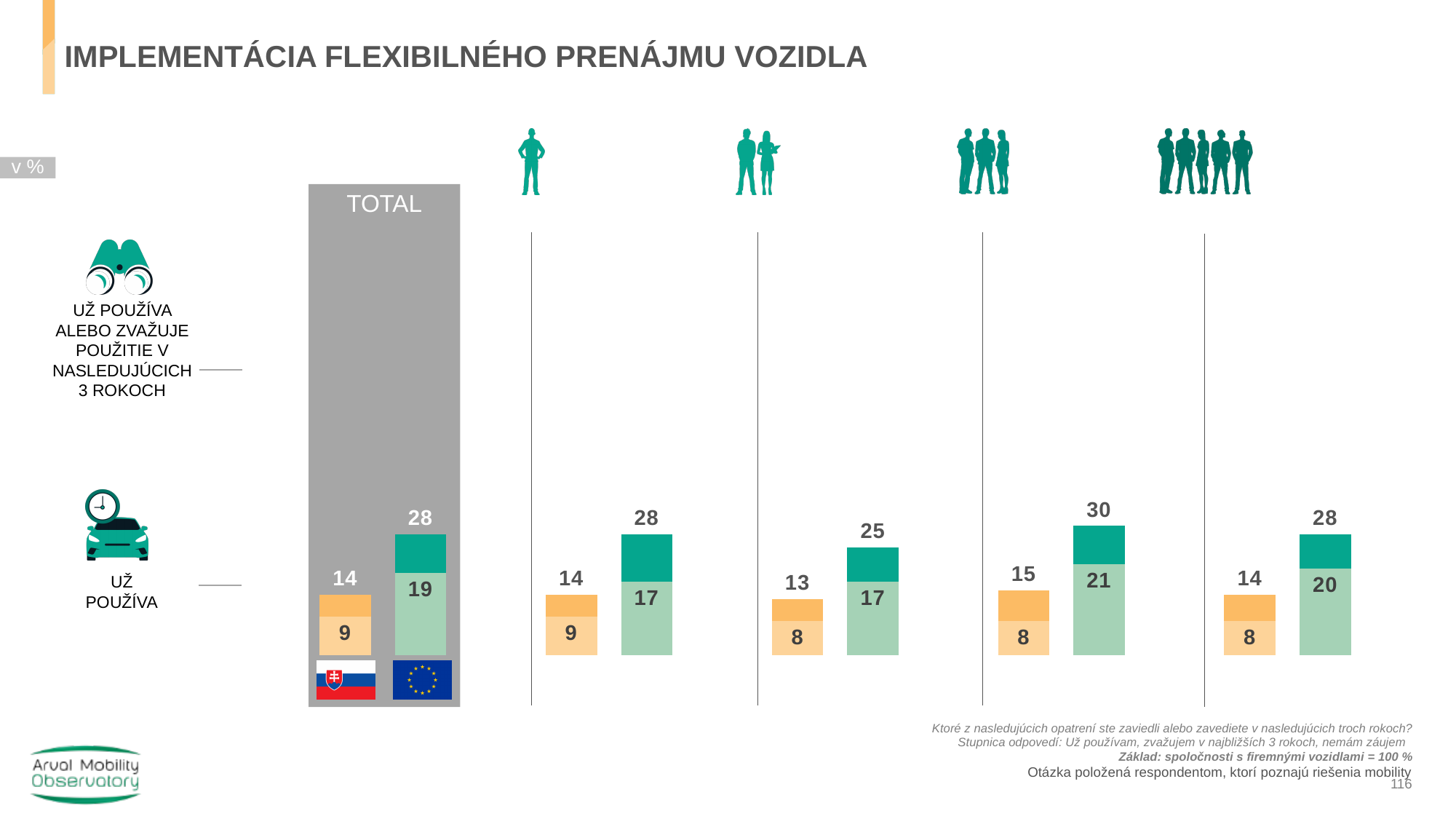
How many company-size groups are shown to the right of the TOTAL column? 4 In the TOTAL column, what is the EU value for 'už používa'? 19 In the second company-size group (two-person icon), what is the EU value for 'už používa'? 17 In the TOTAL column, what is the difference between the EU and Slovakia values for 'už používa alebo zvažuje použitie v nasledujúcich 3 rokoch'? 14 In the TOTAL column, what is the Slovakia value for 'už používa alebo zvažuje použitie v nasledujúcich 3 rokoch'? 14 In the TOTAL column, what is the EU value for 'už používa alebo zvažuje použitie v nasledujúcich 3 rokoch'? 28 In the TOTAL column, what is the Slovakia value for 'už používa'? 9 Across the four company-size groups to the right of TOTAL, which group has the highest EU value for 'už používa alebo zvažuje použitie v nasledujúcich 3 rokoch'? The third group (three-person icon), 30 Across the four company-size groups to the right of TOTAL, which group has the lowest Slovakia value for 'už používa alebo zvažuje použitie v nasledujúcich 3 rokoch'? The second group (two-person icon), 13 In the third company-size group (three-person icon), what is the Slovakia value for 'už používa'? 8 What type of chart is shown on the slide? Bar chart In the fourth company-size group (five-person icon), which is larger: the Slovakia value or the EU value for 'už používa alebo zvažuje použitie v nasledujúcich 3 rokoch'? EU (28)